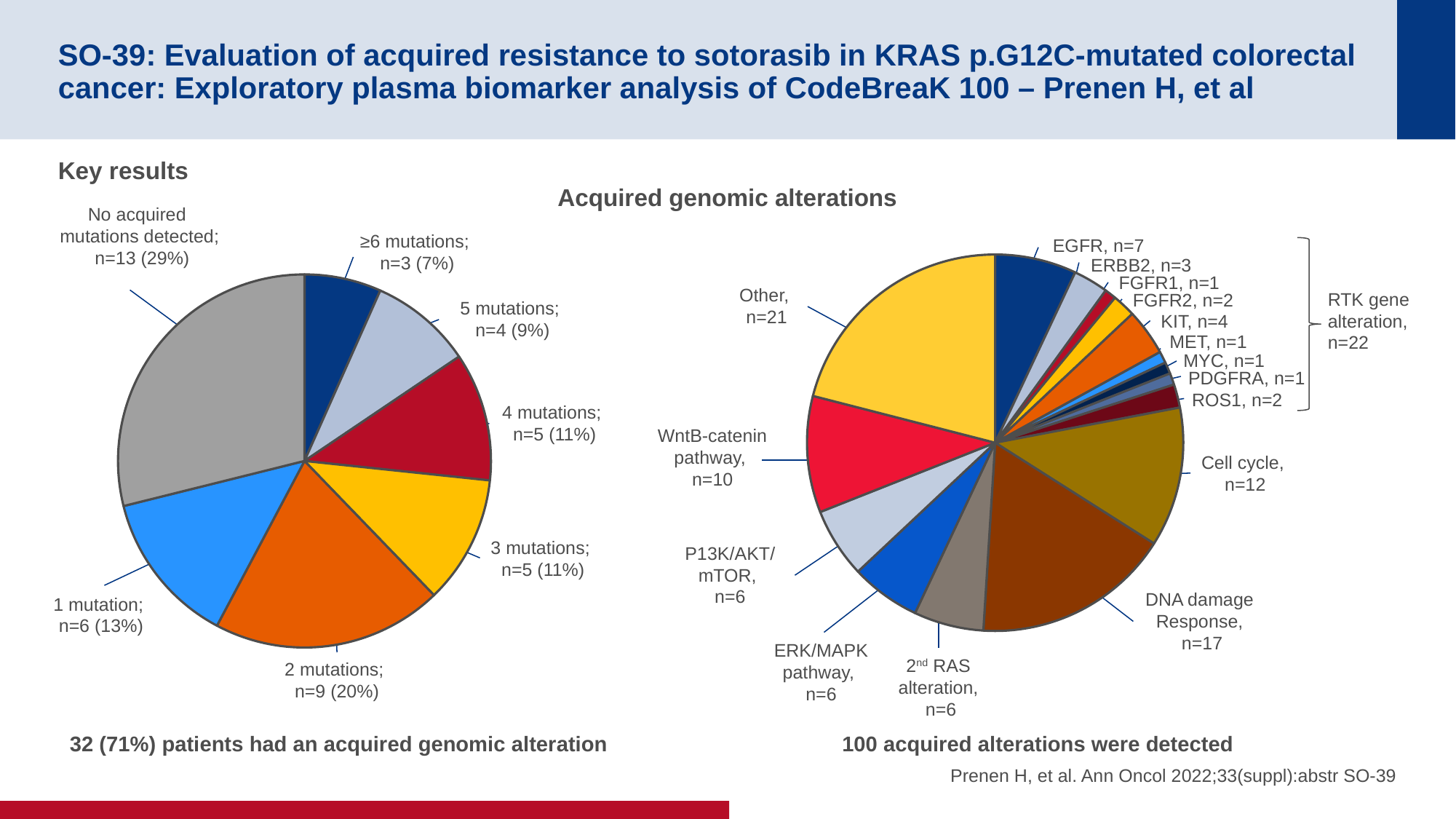
In the right pie chart (Acquired genomic alterations), which category has the largest slice? Other In the right pie chart (Acquired genomic alterations), how many alterations were in the DNA damage response category? n=17 In the left pie chart, which category has the largest slice? No acquired mutations detected In the right pie chart (Acquired genomic alterations), what is the total number of RTK gene alterations indicated by the bracket? n=22 What type of charts are shown on the slide? Pie charts In the left pie chart, what percentage of patients had 2 mutations? 20% In the right pie chart (Acquired genomic alterations), which is larger: Cell cycle or WntB-catenin pathway? Cell cycle In the left pie chart, which category has the smallest slice? ≥6 mutations In the left pie chart, how many patients had no acquired mutations detected? n=13 (29%) In the right pie chart (Acquired genomic alterations), what is the difference between the number of EGFR alterations and KIT alterations? 3 In the left pie chart, how many categories are shown? 7 In the left pie chart, how many more patients had 2 mutations than 1 mutation? 3